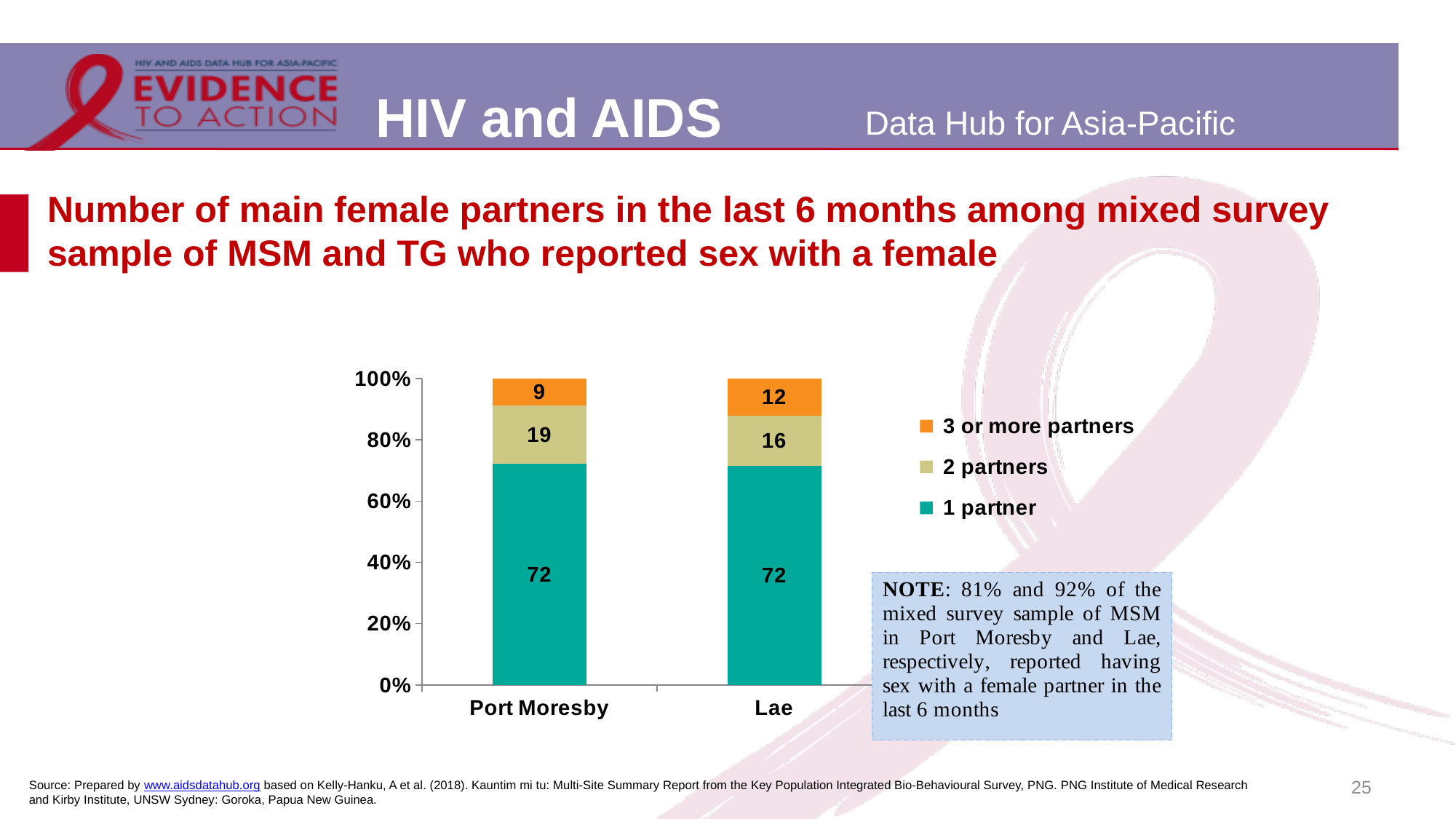
What is the difference between the '2 partners' values for Port Moresby and Lae? 3 Which city has the higher value for '2 partners', Port Moresby or Lae? Port Moresby Which series has the highest value in Lae? 1 partner Which series has the lowest value in Port Moresby? 3 or more partners How many series does the legend list? 3 What kind of chart is shown on the slide? Stacked bar chart How many cities are shown on the x axis? 2 What is the value for '3 or more partners' in Port Moresby? 9 What is the value for '1 partner' in Port Moresby? 72 What is the value for '3 or more partners' in Lae? 12 What is the difference between the '3 or more partners' values for Lae and Port Moresby? 3 What is the value for '2 partners' in Lae? 16